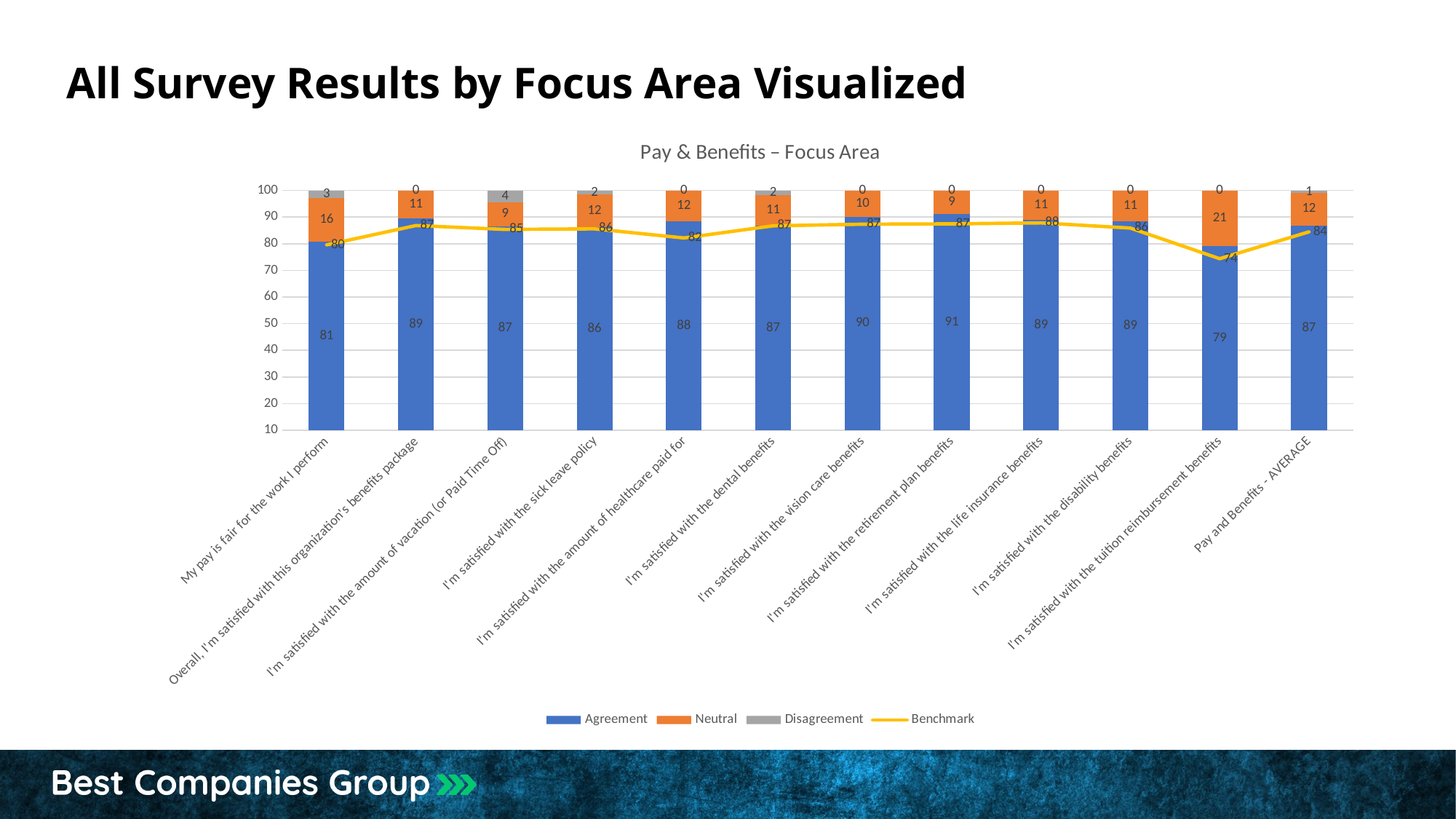
What is the title of the chart? Pay & Benefits – Focus Area Which is larger, the Agreement value for "I'm satisfied with the vision care benefits" or for "I'm satisfied with the dental benefits"? I'm satisfied with the vision care benefits What is the Neutral value for "I'm satisfied with the tuition reimbursement benefits"? 21 What is the difference between the Agreement value and the Benchmark value for "I'm satisfied with the amount of healthcare paid for"? 6 Which category has the lowest Benchmark value? I'm satisfied with the tuition reimbursement benefits Which category has the highest Agreement value? I'm satisfied with the retirement plan benefits How many series does the legend list? 4 What kind of chart is this? Stacked bar chart with a line What is the Benchmark value for "My pay is fair for the work I perform"? 80 How many categories are shown on the x axis? 12 What is the Disagreement value for "I'm satisfied with the amount of vacation (or Paid Time Off)"? 4 What is the Agreement value for "I'm satisfied with the retirement plan benefits"? 91